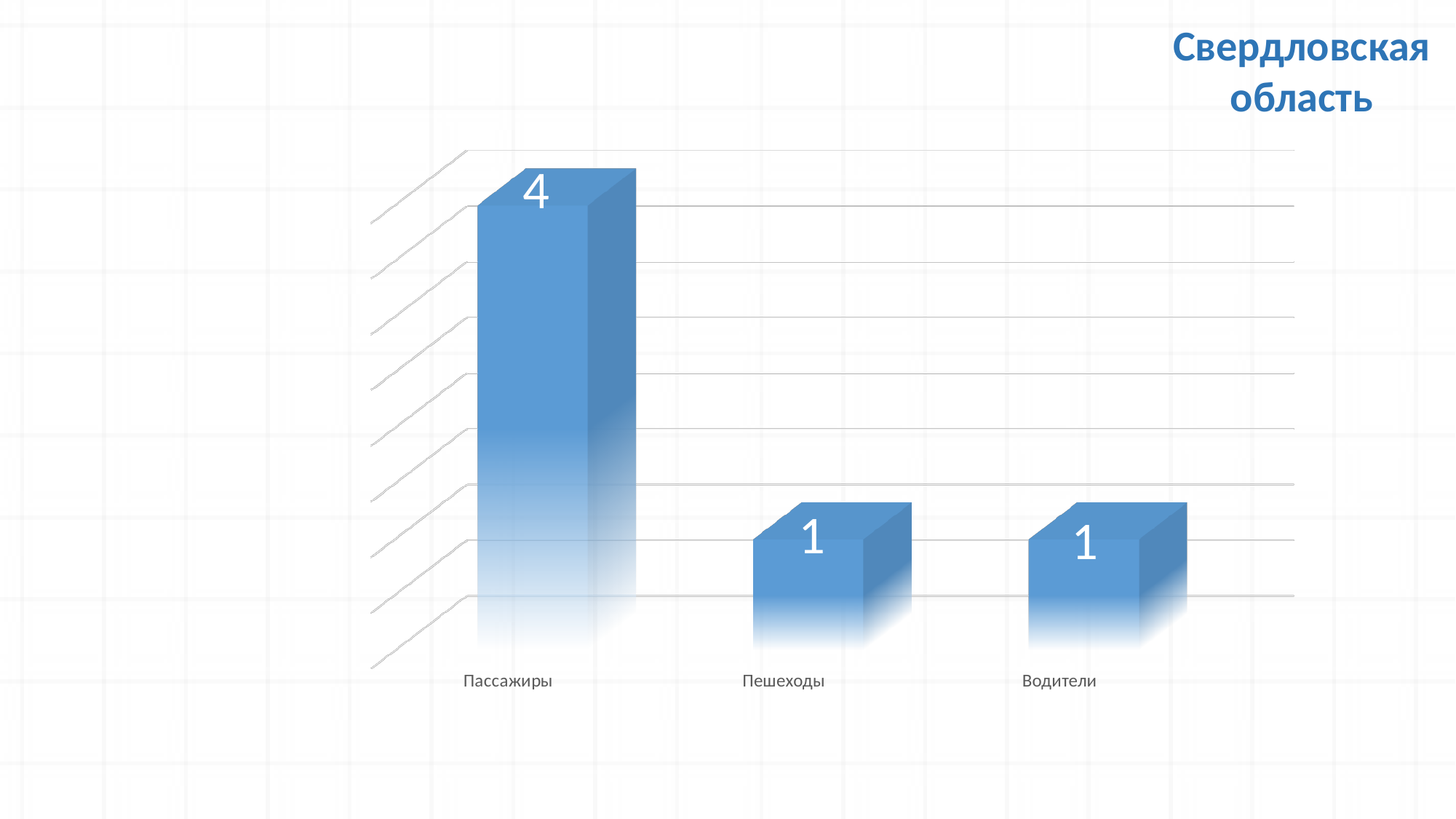
What is the value for Пешеходы? 1 How many categories are shown on the x axis? 3 What is the difference between the values for Пассажиры and Пешеходы? 3 What kind of chart is shown on the slide? bar chart What colour are the bars in the chart? blue Do the values rise or fall from Пассажиры to Пешеходы? fall Which is larger, the value for Пассажиры or the value for Водители? Пассажиры What is the value for Водители? 1 What region name is written in the top right corner of the slide? Свердловская область What is the total of the values for all three categories? 6 Which category has the highest value? Пассажиры What is the value for Пассажиры? 4